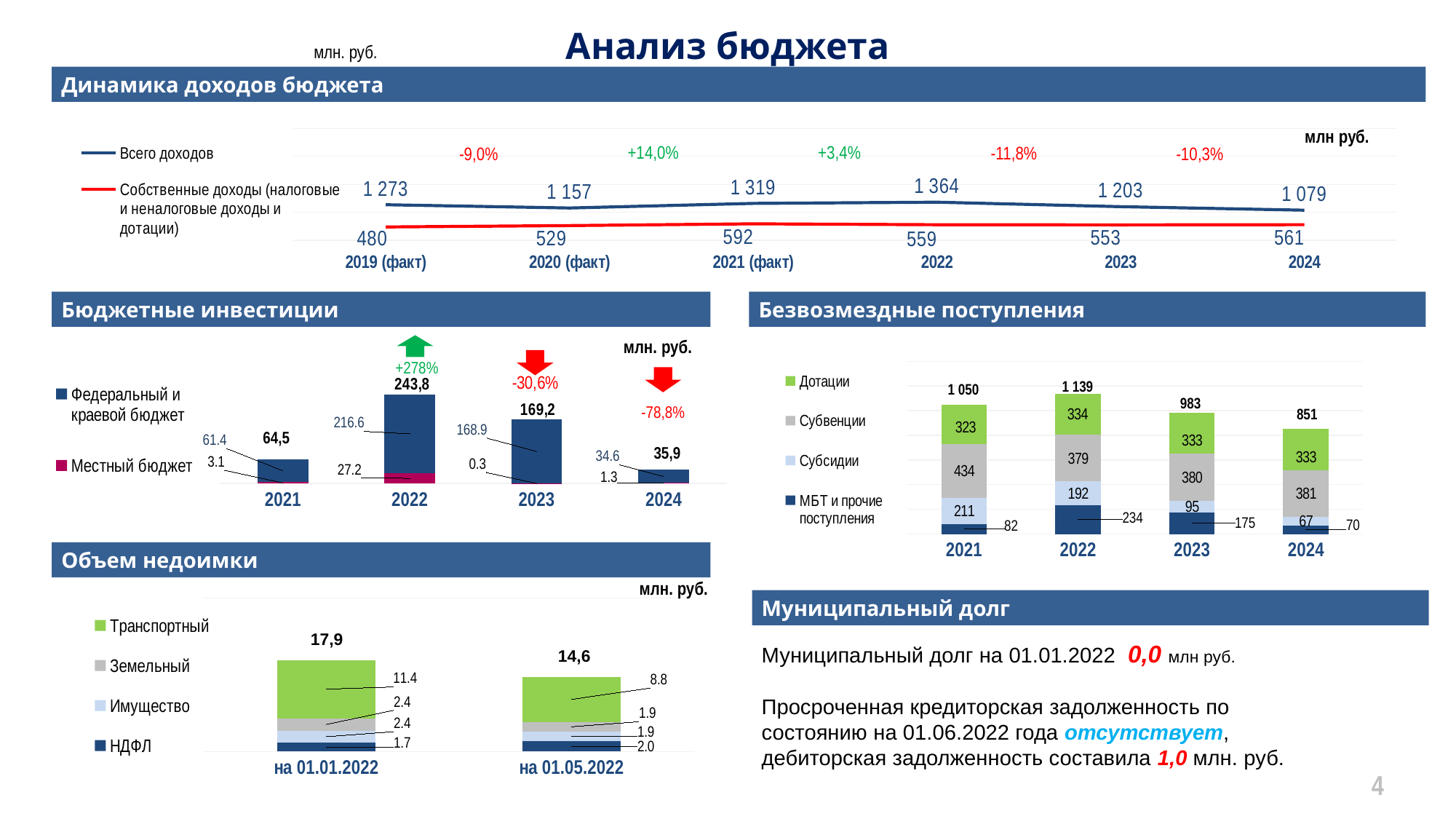
In the 'Бюджетные инвестиции' chart, what is the total value shown above the 2022 bar? 243,8 In the 'Динамика доходов бюджета' chart, what is the value of 'Всего доходов' for 2022? 1 364 In the 'Безвозмездные поступления' chart, what is the difference between 'Дотации' in 2022 and in 2021? 11 In the 'Объем недоимки' chart, what is the value of 'Транспортный' на 01.05.2022? 8.8 In the 'Бюджетные инвестиции' chart, what is the value of 'Местный бюджет' for 2022? 27.2 In the 'Безвозмездные поступления' chart, which year has the highest total? 2022 In the 'Динамика доходов бюджета' chart, what is the value of 'Собственные доходы' for 2021 (факт)? 592 How many years (categories) are shown in the 'Бюджетные инвестиции' chart? 4 What kind of chart is the 'Динамика доходов бюджета' chart? line chart In the 'Динамика доходов бюджета' chart, in which year is 'Всего доходов' highest? 2022 How many series does the legend of the 'Динамика доходов бюджета' chart list? 2 In the 'Безвозмездные поступления' chart, what is the value of 'Субвенции' for 2021? 434